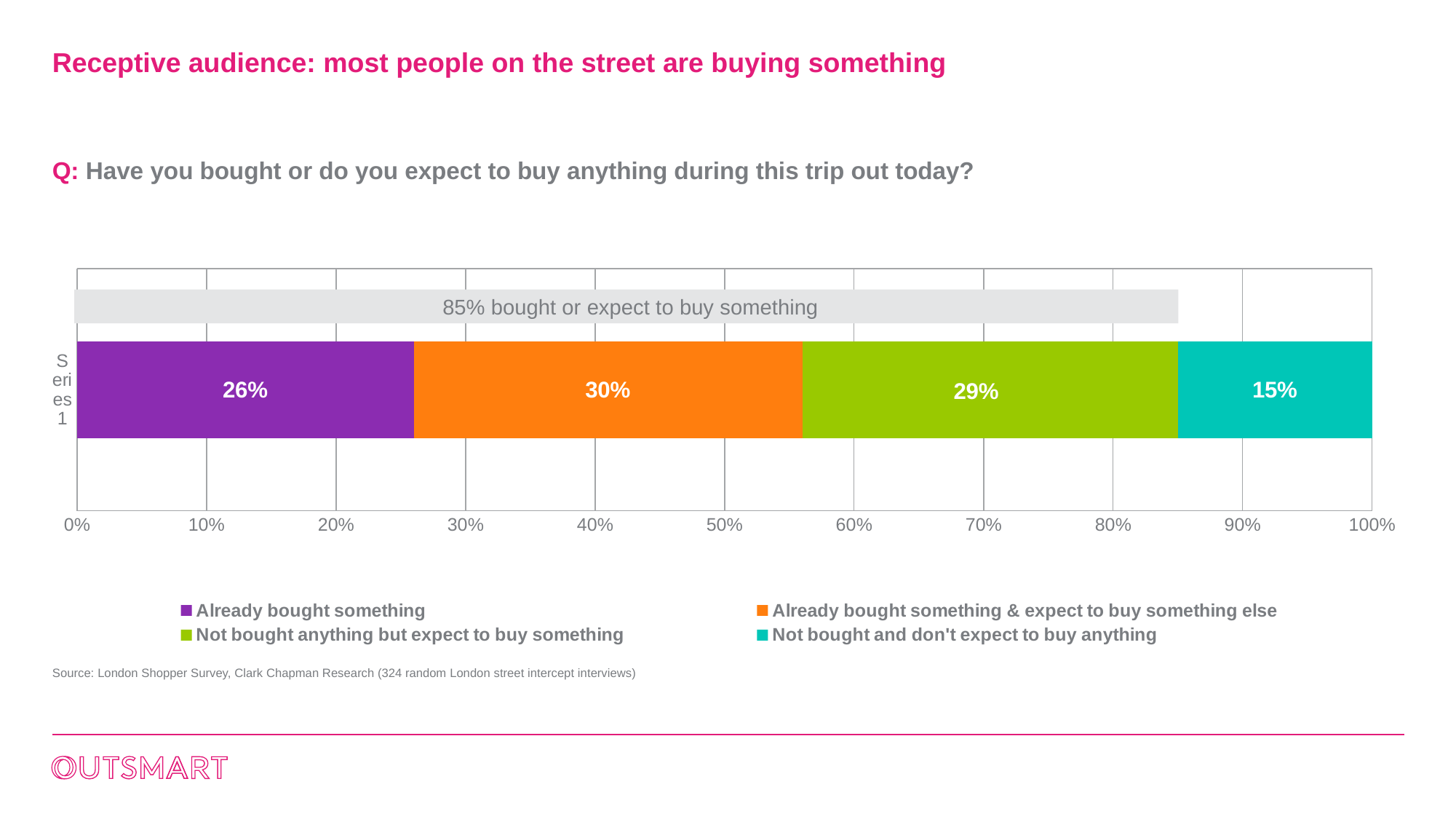
How many series does the legend list? 4 Which response category has the smallest share? Not bought and don't expect to buy anything What percentage of respondents had already bought something (and did not expect to buy anything else)? 26% According to the label above the bar, what percentage of people bought or expect to buy something? 85% Which response category has the largest share? Already bought something & expect to buy something else What percentage of respondents had not bought and don't expect to buy anything? 15% What kind of chart is shown on the slide? Stacked bar chart Which is larger: the share for 'Already bought something' or the share for 'Not bought anything but expect to buy something'? Not bought anything but expect to buy something What is the difference in percentage points between 'Already bought something & expect to buy something else' and 'Not bought and don't expect to buy anything'? 15 percentage points What percentage of respondents had already bought something and expect to buy something else? 30% What is the total of all four segments of the stacked bar? 100% What percentage of respondents had not bought anything but expect to buy something? 29%